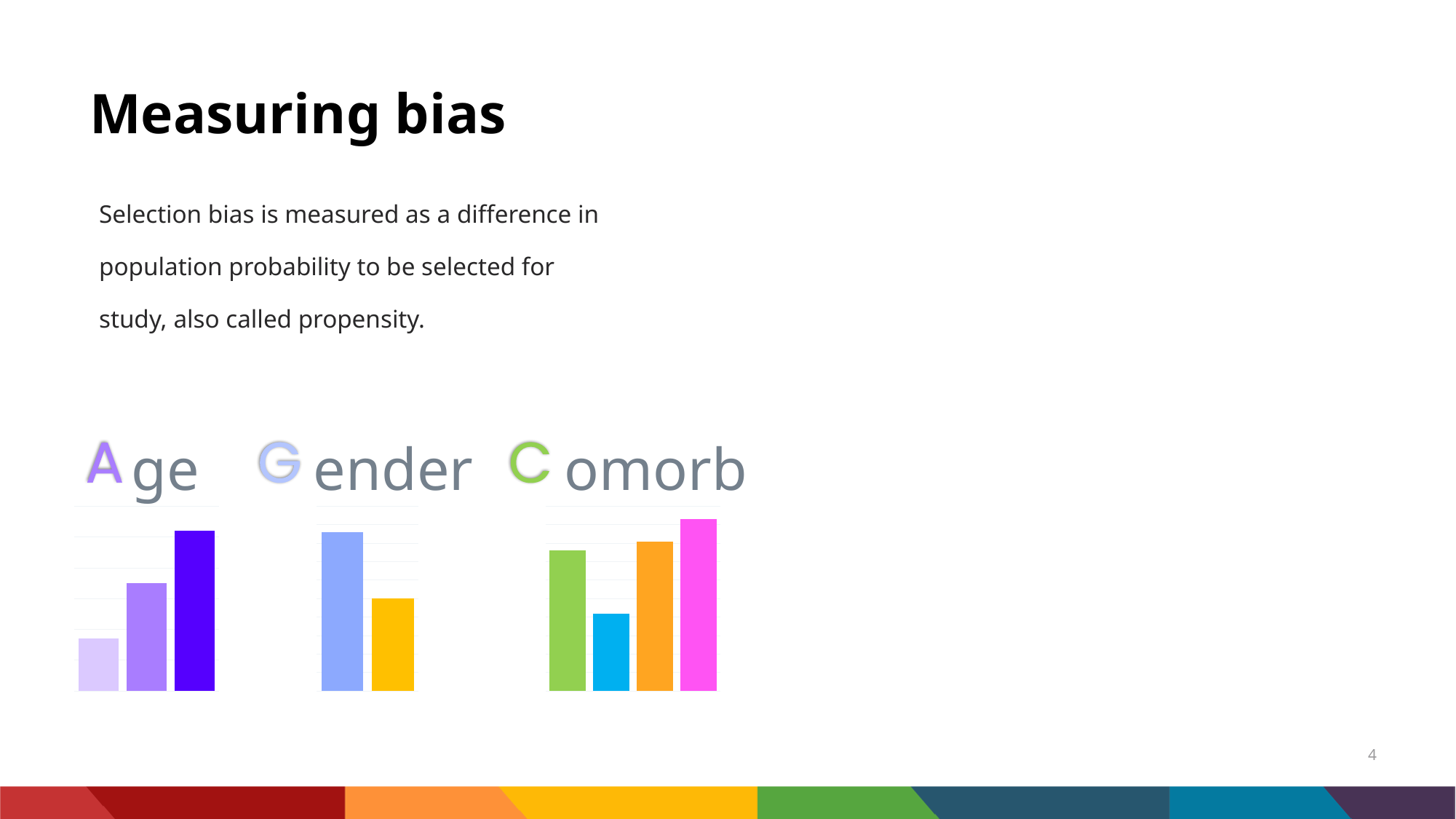
How many separate bar charts are shown on the slide? 3 How many bars does the "Comorb" chart have? 4 In the "Gender" chart, do the bars rise or fall from left to right? fall In the "Age" chart, which bar is the tallest: the first, second or third? third In the "Gender" chart, which bar is taller: the left (blue) bar or the right (yellow) bar? the left (blue) bar In the "Comorb" chart, which bar is the tallest: the first, second, third or fourth? fourth How many bars does the "Age" chart have? 3 How many bars does the "Gender" chart have? 2 In the "Comorb" chart, which bar is taller: the green bar or the orange bar? the orange bar In the "Age" chart, do the bars rise or fall from left to right? rise In the "Comorb" chart, which bar is the shortest: the first, second, third or fourth? second What kind of chart is shown under the "Age" label? bar chart